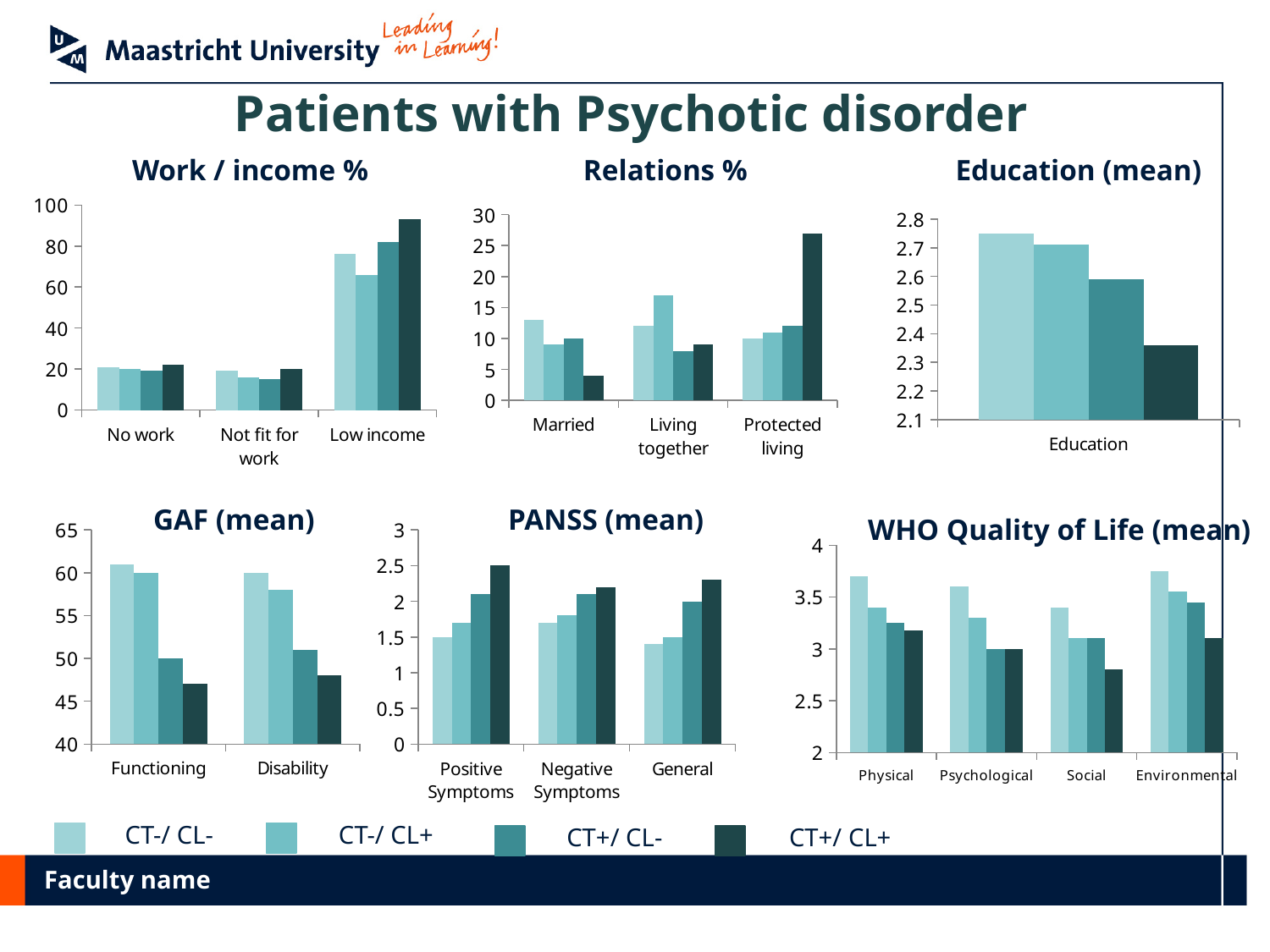
In the Relations % chart, which group has the highest value for Protected living? CT+/ CL+ In the Relations % chart, for Living together, which is larger: CT-/ CL+ or CT+/ CL-? CT-/ CL+ In the Relations % chart, is the value for CT+/ CL+ in the Married category greater or less than 5? less In the Work / income % chart, is the value for CT+/ CL+ in the Low income category greater or less than 80? greater In the WHO Quality of Life (mean) chart, is the value for CT+/ CL+ in the Social category greater or less than 3? less How many categories are shown on the x axis of the PANSS (mean) chart? 3 In the Education (mean) chart, which group has the lowest mean? CT+/ CL+ In the Work / income % chart, which category has the tallest bars? Low income In the PANSS (mean) chart, which group has the highest value for Positive Symptoms? CT+/ CL+ In the Education (mean) chart, do the bars rise or fall from left to right? fall How many series does the shared legend at the bottom of the slide list? 4